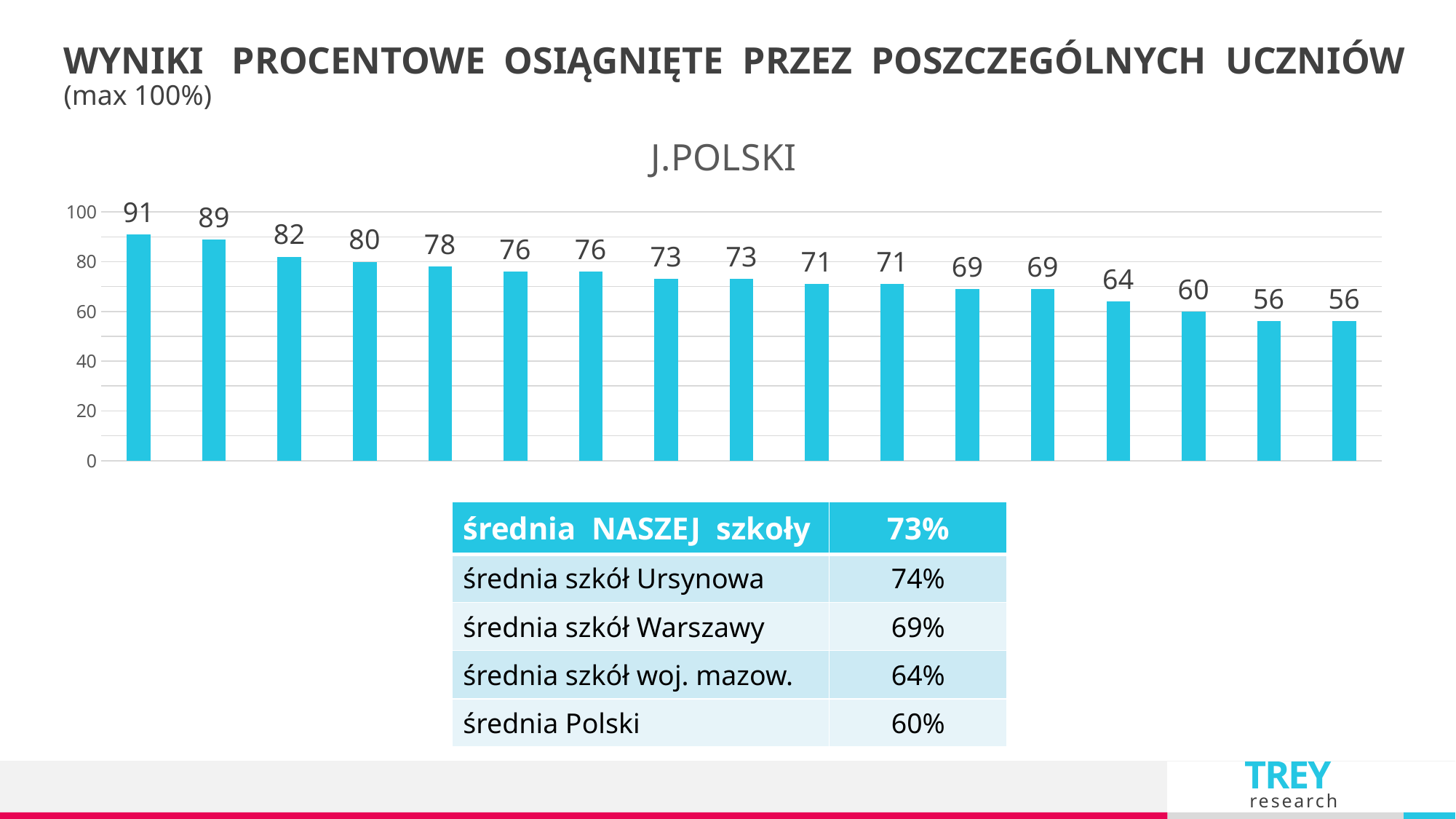
What is the difference between the leftmost bar (91) and the rightmost bar (56)? 35 What is the title of the chart? J.POLSKI Which is larger: the value of the fifth bar from the left or the value of the sixth bar from the left? the fifth bar (78) What is the lowest value shown in the chart? 56 How many bars are plotted in the chart? 17 Is the value of the third bar from the left greater or less than 80? greater What is the value of the leftmost bar in the chart? 91 What is the highest value shown in the chart? 91 What kind of chart is shown on the slide? bar chart Do the bar values rise or fall from left to right across the chart? fall What is the value of the rightmost bar in the chart? 56 What is the value of the second bar from the left? 89